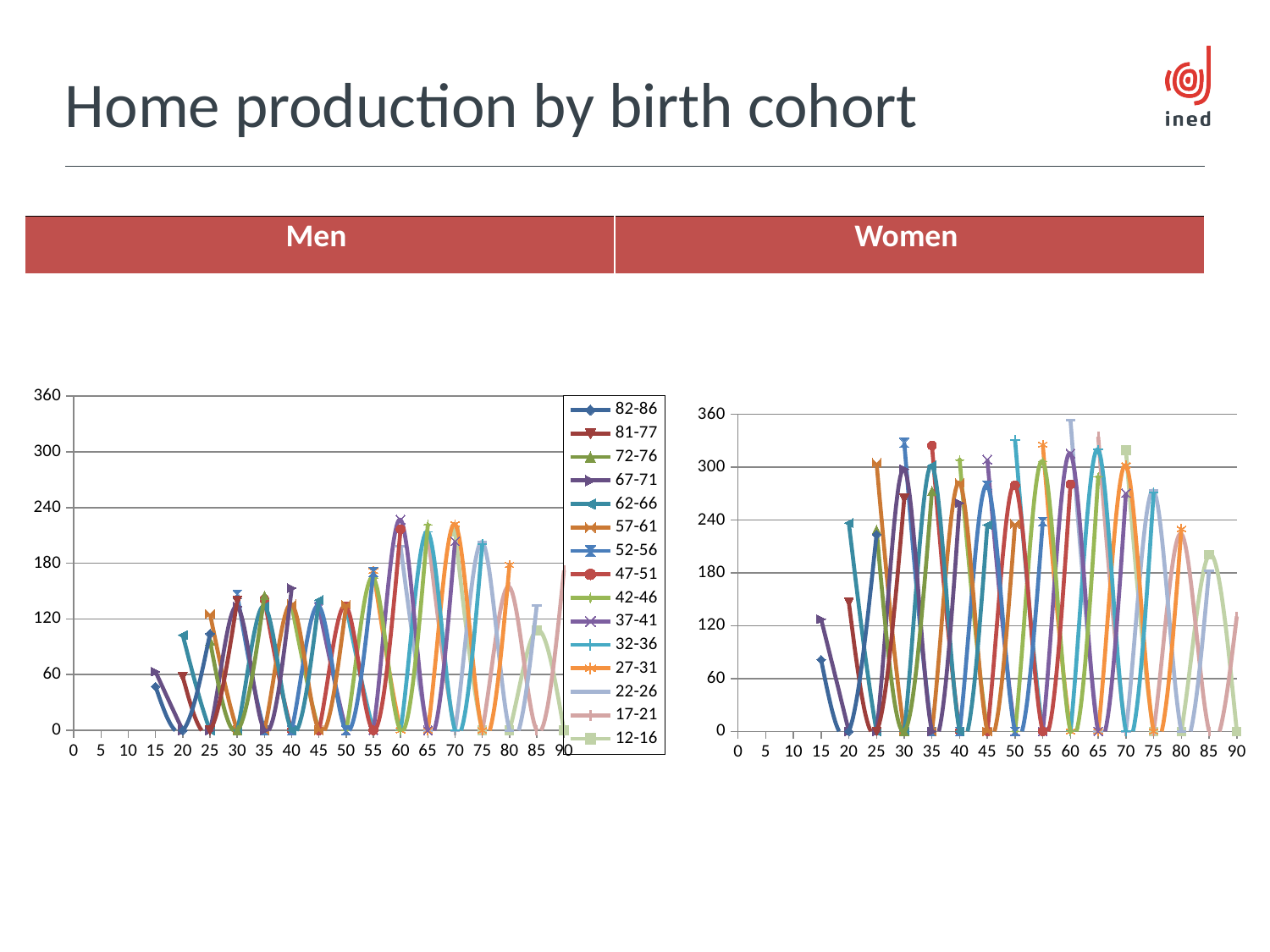
On the Women chart, is the value of the 12-16 series at age 85 greater or less than 180? greater On the Men chart, is the value of the 82-86 series at age 15 greater or less than 60? less What kind of chart is the Men chart? line chart On the Women chart, is the value of the 17-21 series at age 90 greater or less than 120? greater What is the last series listed in the legend of the Men chart? 12-16 What is the highest value shown on the y axis of the Women chart? 360 Which chart reaches higher peak values, the Men chart or the Women chart? Women What is the first series listed in the legend of the Men chart? 82-86 How many series does the legend of the Men chart list? 15